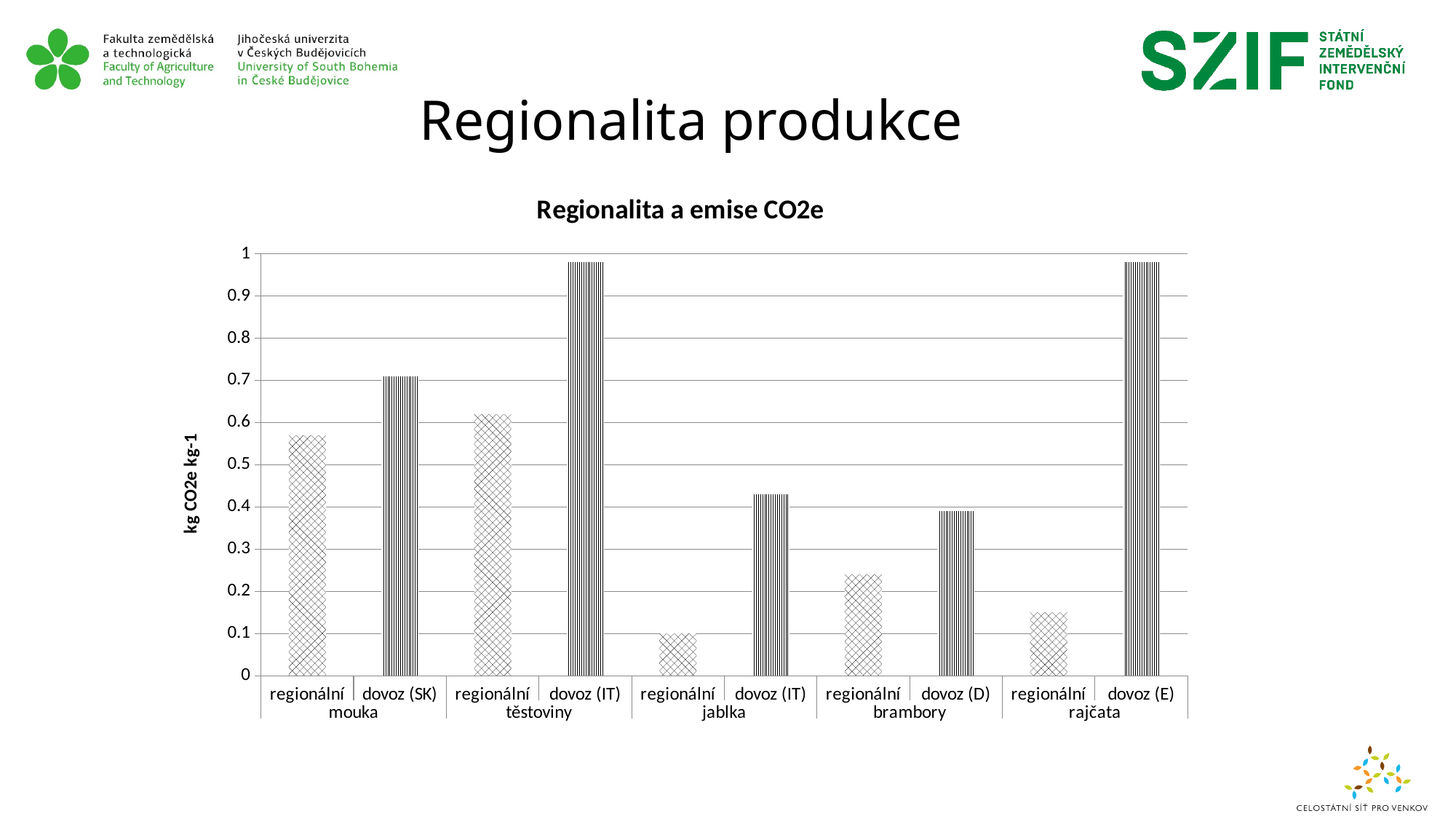
For brambory, which is larger: regionální or dovoz (D)? dovoz (D) Is the value for dovoz (IT) jablka greater or less than 0.5? less For mouka, which is larger: regionální or dovoz (SK)? dovoz (SK) Is the value for regionální rajčata greater or less than 0.2? less How many bars are plotted in the chart? 10 Is the value for regionální mouka greater or less than 0.5? greater What kind of chart is shown on the slide? bar chart What is the title of the chart? Regionalita a emise CO2e How many product groups are shown along the x axis? 5 What is the label of the vertical axis? kg CO2e kg-1 Which bar has the lowest value in the chart? regionální jablka